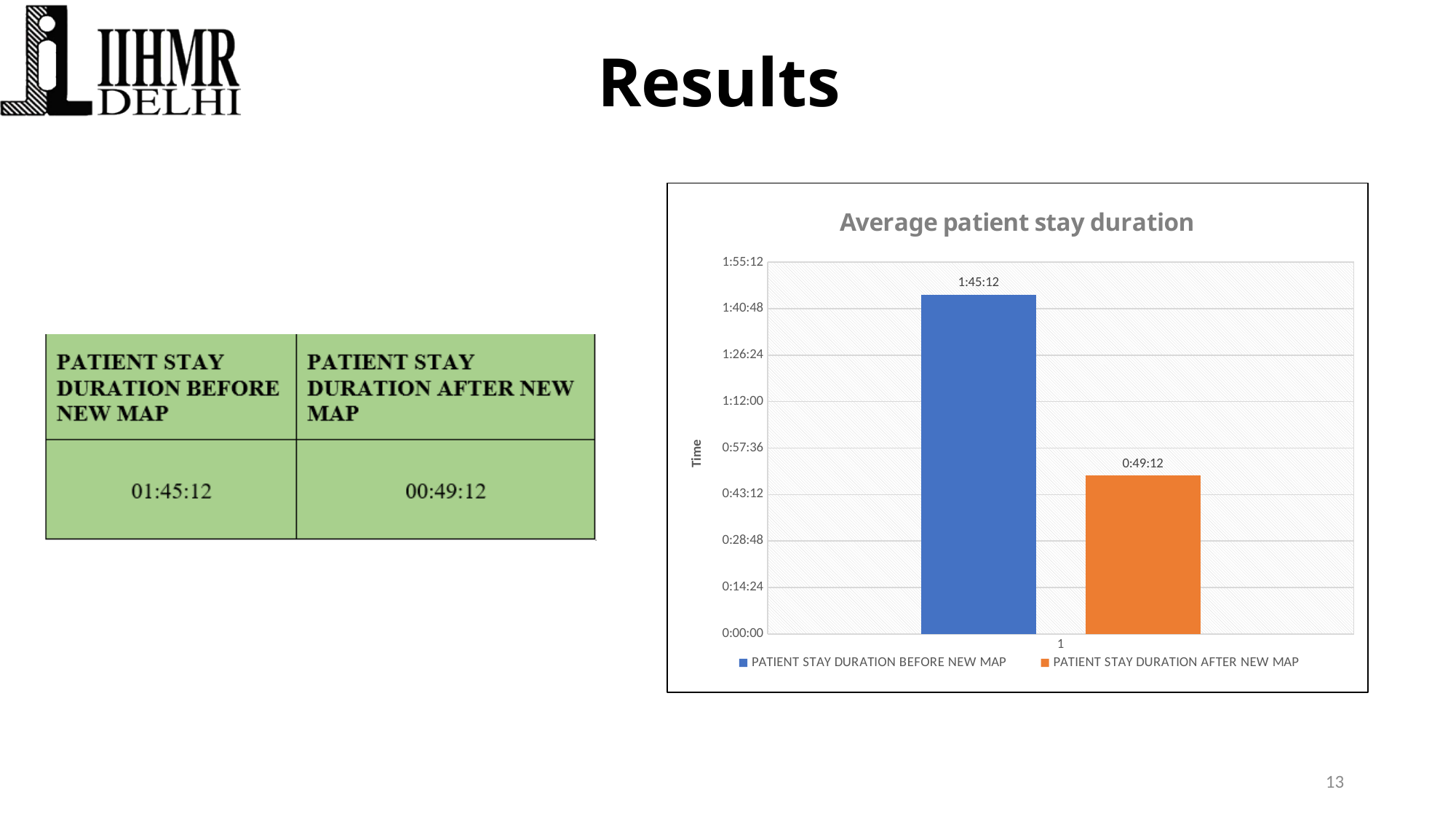
How many series does the legend of the Average patient stay duration chart list? 2 What is the value of the PATIENT STAY DURATION AFTER NEW MAP bar in the Average patient stay duration chart? 0:49:12 How many bars are plotted in the Average patient stay duration chart? 2 Which series has the higher value in the Average patient stay duration chart? PATIENT STAY DURATION BEFORE NEW MAP Is the value for PATIENT STAY DURATION BEFORE NEW MAP greater or less than 1:40:48? greater What is the value of the PATIENT STAY DURATION BEFORE NEW MAP bar in the Average patient stay duration chart? 1:45:12 What is the label of the vertical axis in the Average patient stay duration chart? Time Is the PATIENT STAY DURATION BEFORE NEW MAP bar larger or smaller than the PATIENT STAY DURATION AFTER NEW MAP bar? larger Is the value for PATIENT STAY DURATION AFTER NEW MAP greater or less than 0:57:36? less By how much does the patient stay duration before the new map exceed the duration after the new map in the chart? 0:56:00 Which series has the lower value in the Average patient stay duration chart? PATIENT STAY DURATION AFTER NEW MAP What kind of chart is the Average patient stay duration chart? bar chart